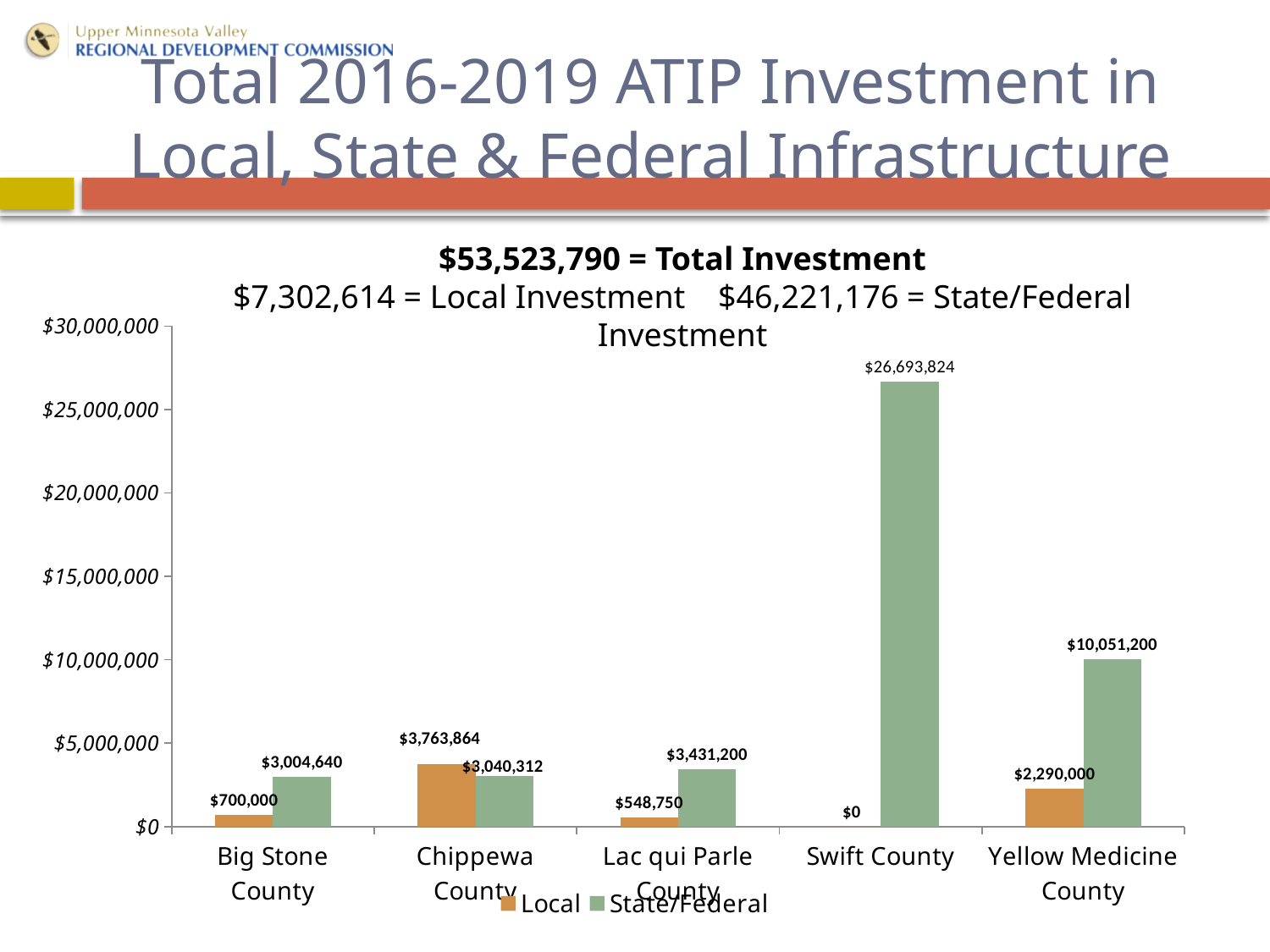
What is the State/Federal investment for Swift County? $26,693,824 How many series does the legend list? 2 Which is larger for Chippewa County, the Local investment or the State/Federal investment? Local Which county has the lowest Local investment? Swift County What kind of chart is shown on the slide? Bar chart Is the State/Federal investment for Yellow Medicine County greater or less than $5,000,000? greater How many counties are shown on the x axis? 5 What is the Local investment for Lac qui Parle County? $548,750 What is the difference between the State/Federal and Local investment for Big Stone County? $2,304,640 What is the State/Federal investment for Yellow Medicine County? $10,051,200 Which county has the highest State/Federal investment? Swift County What is the Local investment for Chippewa County? $3,763,864